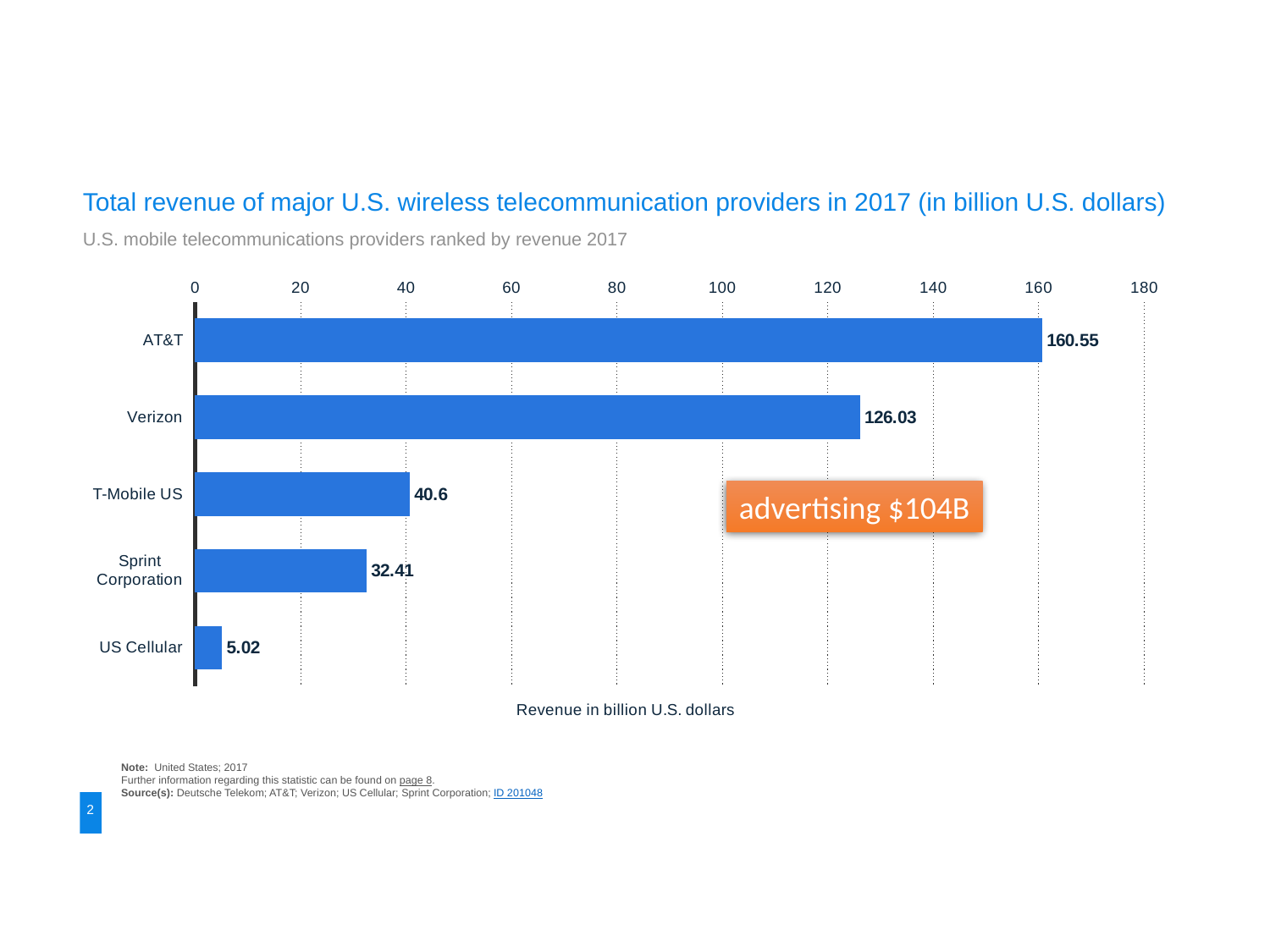
What is the label of the horizontal axis? Revenue in billion U.S. dollars What is the revenue value shown for US Cellular? 5.02 Which has a larger revenue, T-Mobile US or Sprint Corporation? T-Mobile US How many providers are shown in the chart? 5 What kind of chart is shown on the slide? Bar chart Is the value for Verizon greater or less than 120? greater Which provider has the lowest revenue in the chart? US Cellular Which provider has the highest revenue in the chart? AT&T What is the revenue value shown for T-Mobile US? 40.6 What is the revenue value shown for AT&T? 160.55 What is the difference between the revenue of AT&T and Verizon? 34.52 What is the revenue value shown for Verizon? 126.03